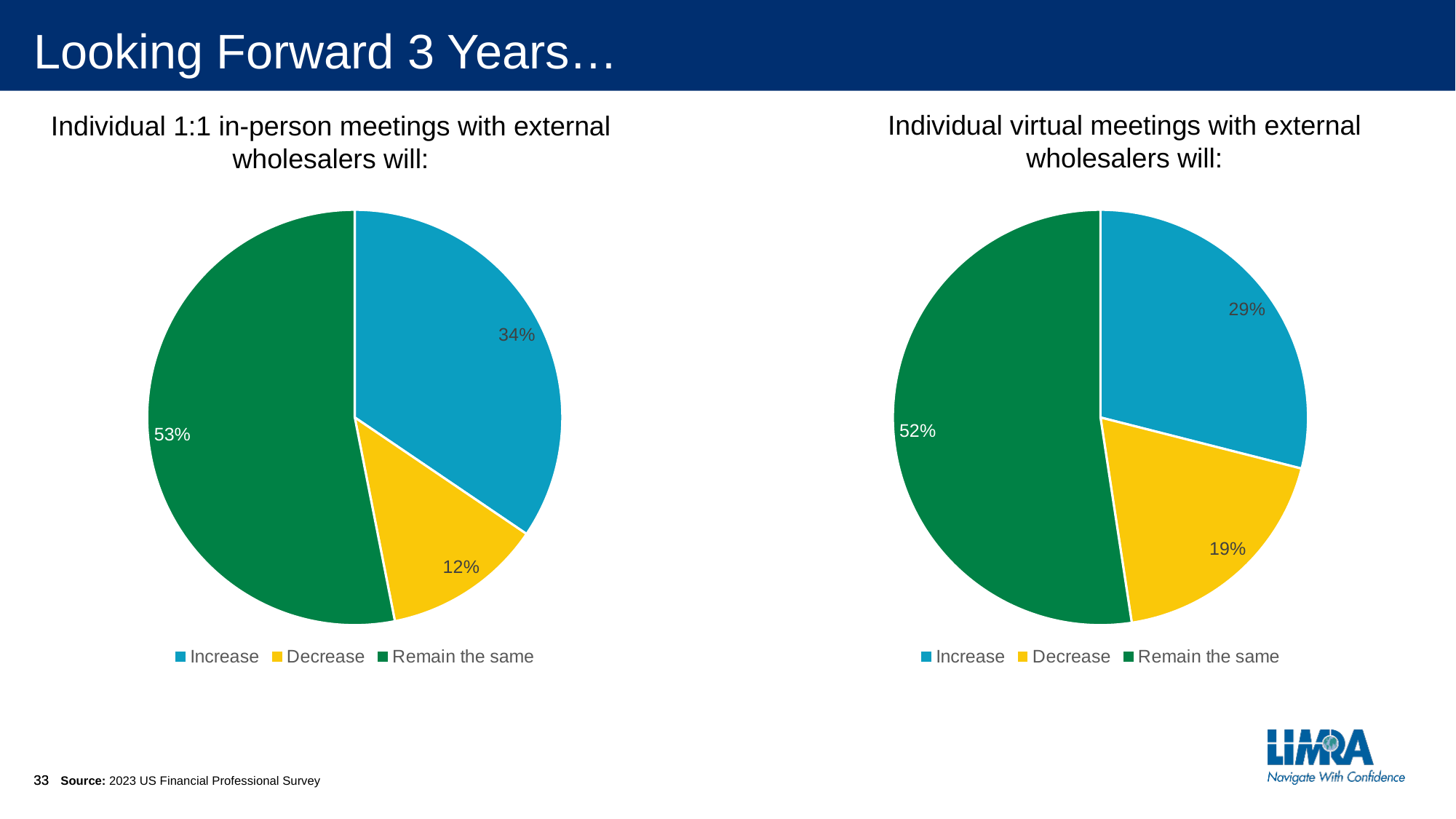
In the left chart (in-person meetings), what share of respondents said meetings will decrease? 12% In the left chart (in-person meetings), which response has the largest slice? Remain the same In the right chart (virtual meetings), what share of respondents said meetings will remain the same? 52% In the right chart (virtual meetings), what is the difference between the Remain the same and Increase shares? 23% In the right chart (virtual meetings), which response has the smallest slice? Decrease What colour represents Remain the same in the legends? Green Which chart shows a larger Decrease share, the left (in-person) or the right (virtual)? Right (virtual) What type of chart is used on this slide? Pie chart In the left chart (in-person meetings), what share of respondents said meetings will increase? 34% In the right chart (virtual meetings), what share of respondents said meetings will decrease? 19% How many slices does the left chart (in-person meetings) have? 3 In the left chart (in-person meetings), what is the difference between the Increase and Decrease shares? 22%